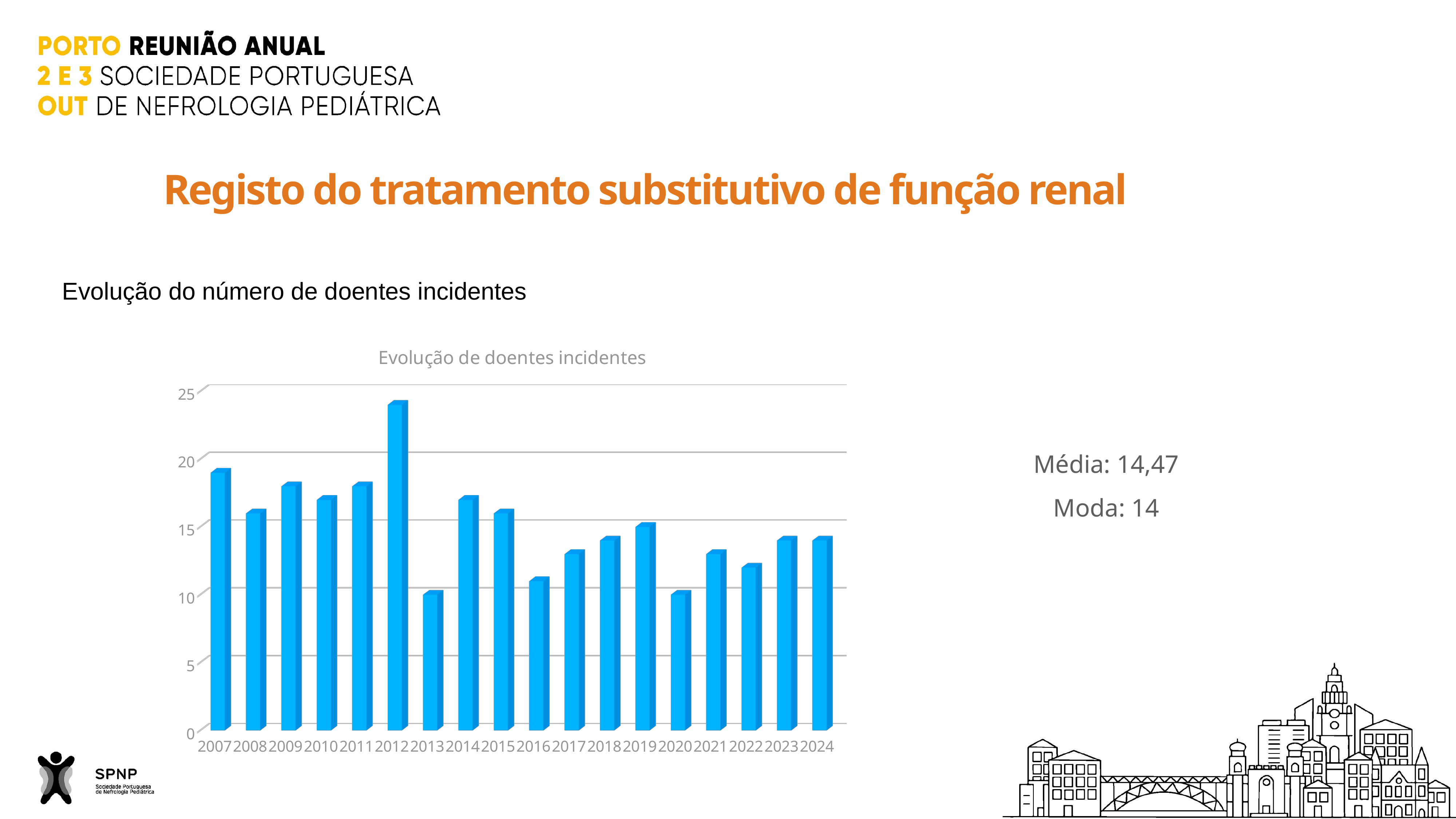
How many years (bars) are shown on the x axis of the chart? 18 Is the value for 2016 greater or less than 15? less Is the value for 2012 greater or less than 20? greater Is the value for 2022 greater or less than 10? greater Which year has the larger value, 2007 or 2008? 2007 Which year has the larger value, 2013 or 2014? 2014 Which year has the highest number of incident patients in the chart? 2012 What is the title of the chart? Evolução de doentes incidentes What kind of chart is shown on the slide? bar chart Overall, do the values rise or fall from 2007 to 2024? fall